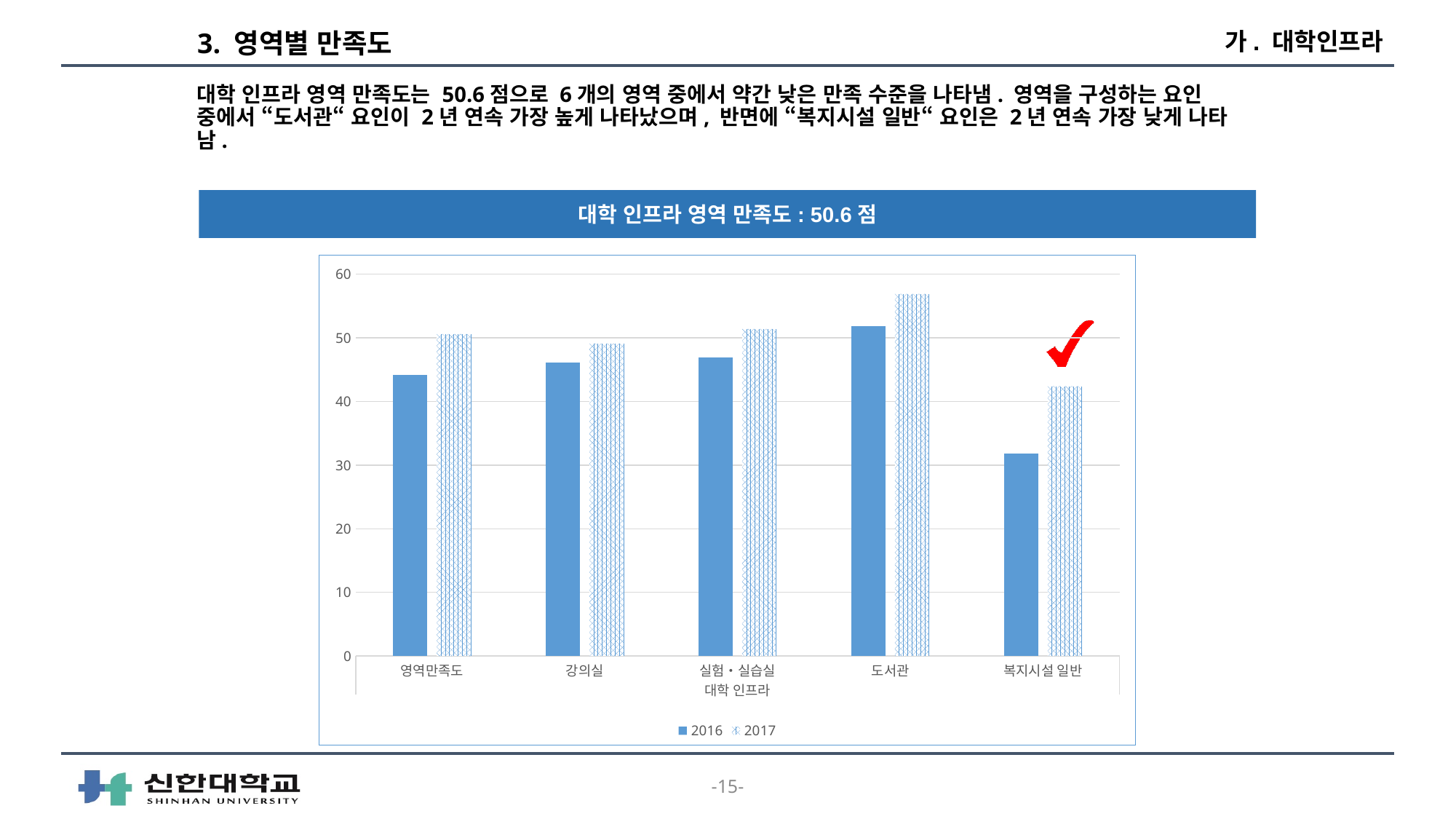
Is the 2016 value for 영역만족도 greater or less than 50? less Which category has the lowest value for the 2016 series? 복지시설 일반 Which category has the highest value for the 2017 series? 도서관 How many series does the legend list? 2 Is the 2016 value for 복지시설 일반 greater or less than 40? less For 복지시설 일반, which series has the larger value, 2016 or 2017? 2017 What are the two entries listed in the chart legend? 2016 and 2017 How many categories are shown on the x axis of the chart? 5 Which category has the highest value for the 2016 series? 도서관 Is the 2017 value for 도서관 greater or less than 50? greater What kind of chart is shown on the slide? Bar chart Which category has the lowest value for the 2017 series? 복지시설 일반